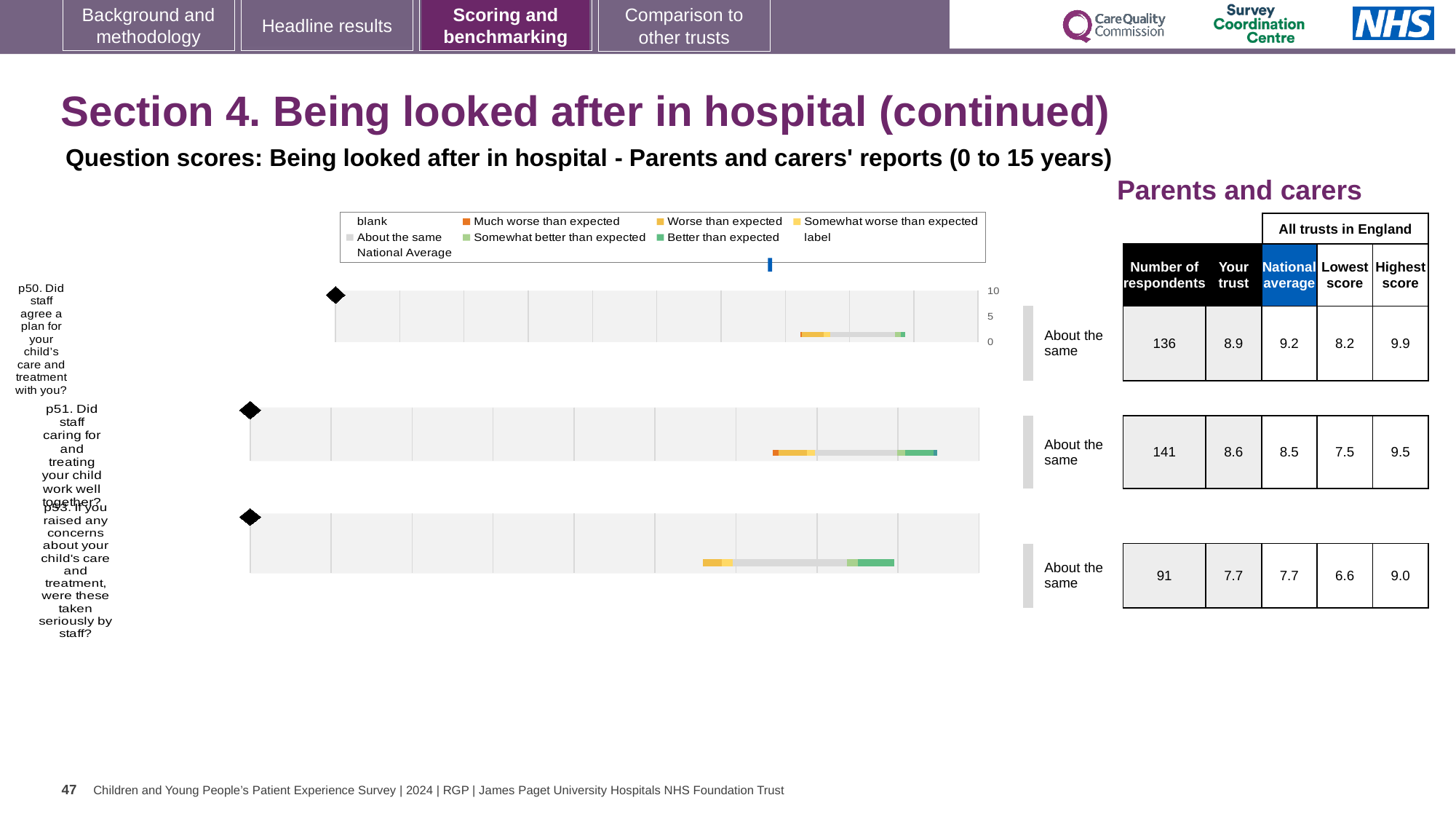
For the p50 chart (staff agree a plan for your child's care), what is the 'Your trust' score shown in the table? 8.9 For the p50 chart, what is the difference between the highest score and the lowest score across all trusts in England? 1.7 For the p51 chart (staff caring for your child work well together), what is the national average score? 8.5 What kind of chart is used for the p50 question? Bar chart Which of the three questions has the highest 'Your trust' score? p50 For the p53 chart, what is the difference between the highest score and the lowest score across all trusts in England? 2.4 For the p51 chart, which is larger: the 'Your trust' score or the national average? Your trust For the p53 chart (concerns taken seriously by staff), how many respondents are listed? 91 How many survey questions are plotted as charts on this slide? 3 What benchmark category is shown next to the p51 chart? About the same Which of the three questions has the lowest 'Your trust' score? p53 In the legend, what does the orange colour represent? Much worse than expected